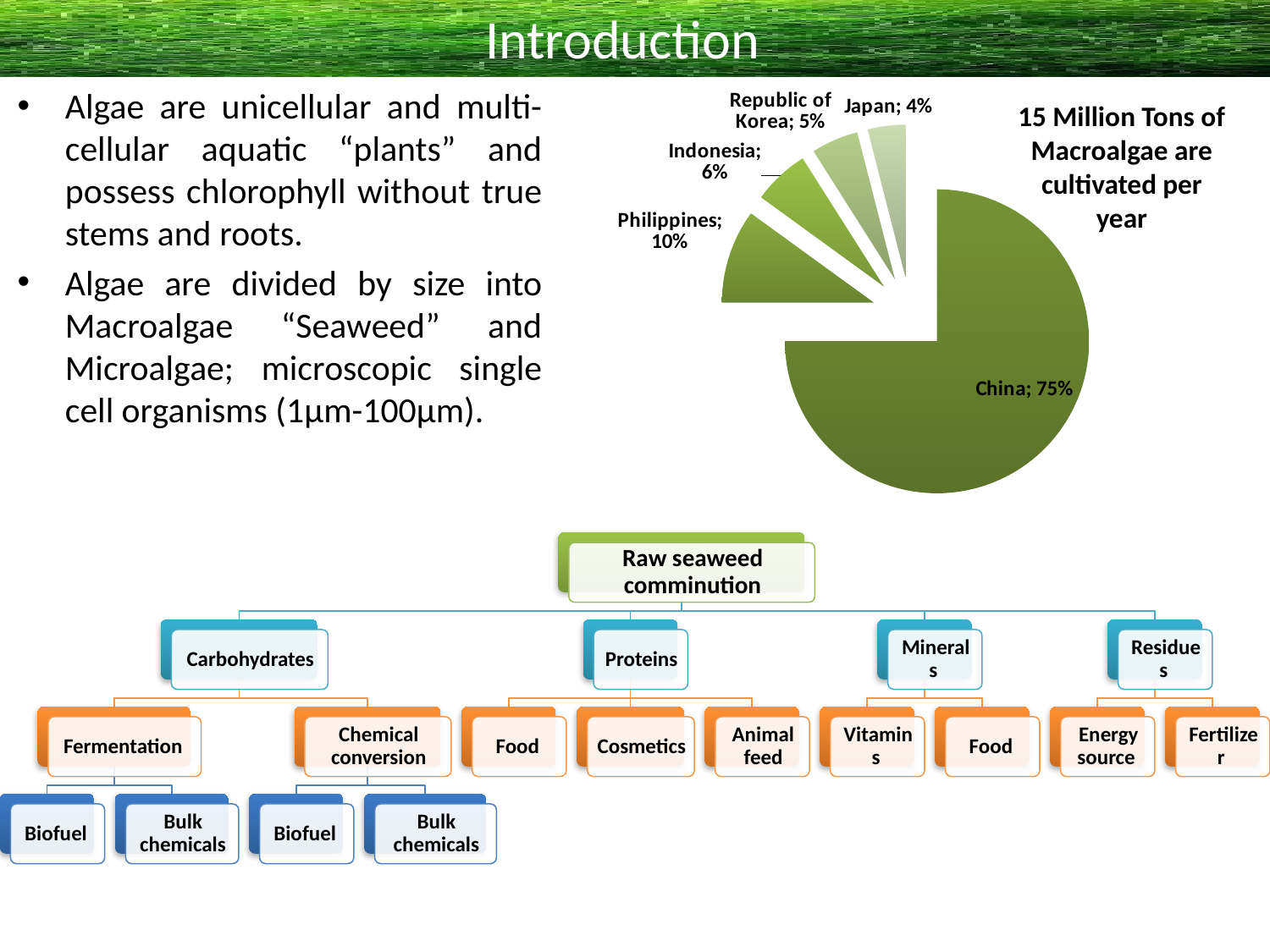
How many countries are shown as slices in the pie chart? 5 What type of chart is shown on the slide? Pie chart Which has a larger share in the pie chart, Indonesia or Republic of Korea? Indonesia What percentage is shown for Japan in the pie chart? 4% Which country has the smallest slice of the pie chart? Japan What is the difference in percentage points between China and the Philippines in the pie chart? 65 What percentage is shown for the Philippines in the pie chart? 10% According to the text next to the pie chart, how many tons of macroalgae are cultivated per year? 15 Million Tons Which country has the largest slice of the pie chart? China What share of the pie chart does China account for? 75% What percentage is shown for Indonesia in the pie chart? 6% What is the difference in percentage points between the Philippines and Japan in the pie chart? 6